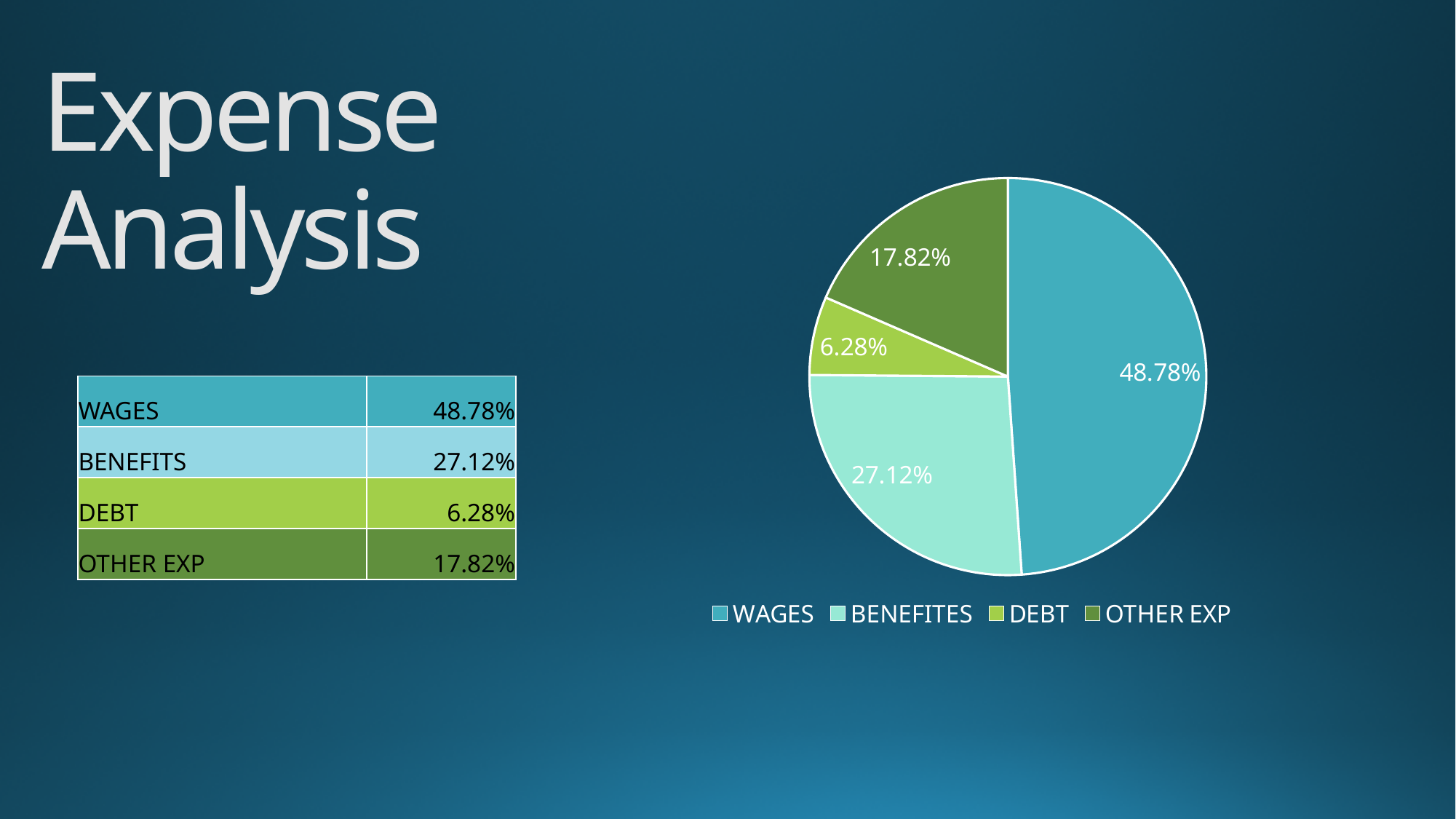
What is the difference between the OTHER EXP and DEBT values? 11.54% Which category has the smallest slice of the pie chart? DEBT What is the difference between the WAGES and BENEFITES values? 21.66% What kind of chart is shown on the slide? pie chart What is the value for OTHER EXP in the pie chart? 17.82% Which category has the largest slice of the pie chart? WAGES Which is larger, the BENEFITES slice or the OTHER EXP slice? BENEFITES What is the value for WAGES in the pie chart? 48.78% How many slices does the pie chart have? 4 What is the value for BENEFITES in the pie chart? 27.12% What is the value for DEBT in the pie chart? 6.28% How many entries does the legend list? 4